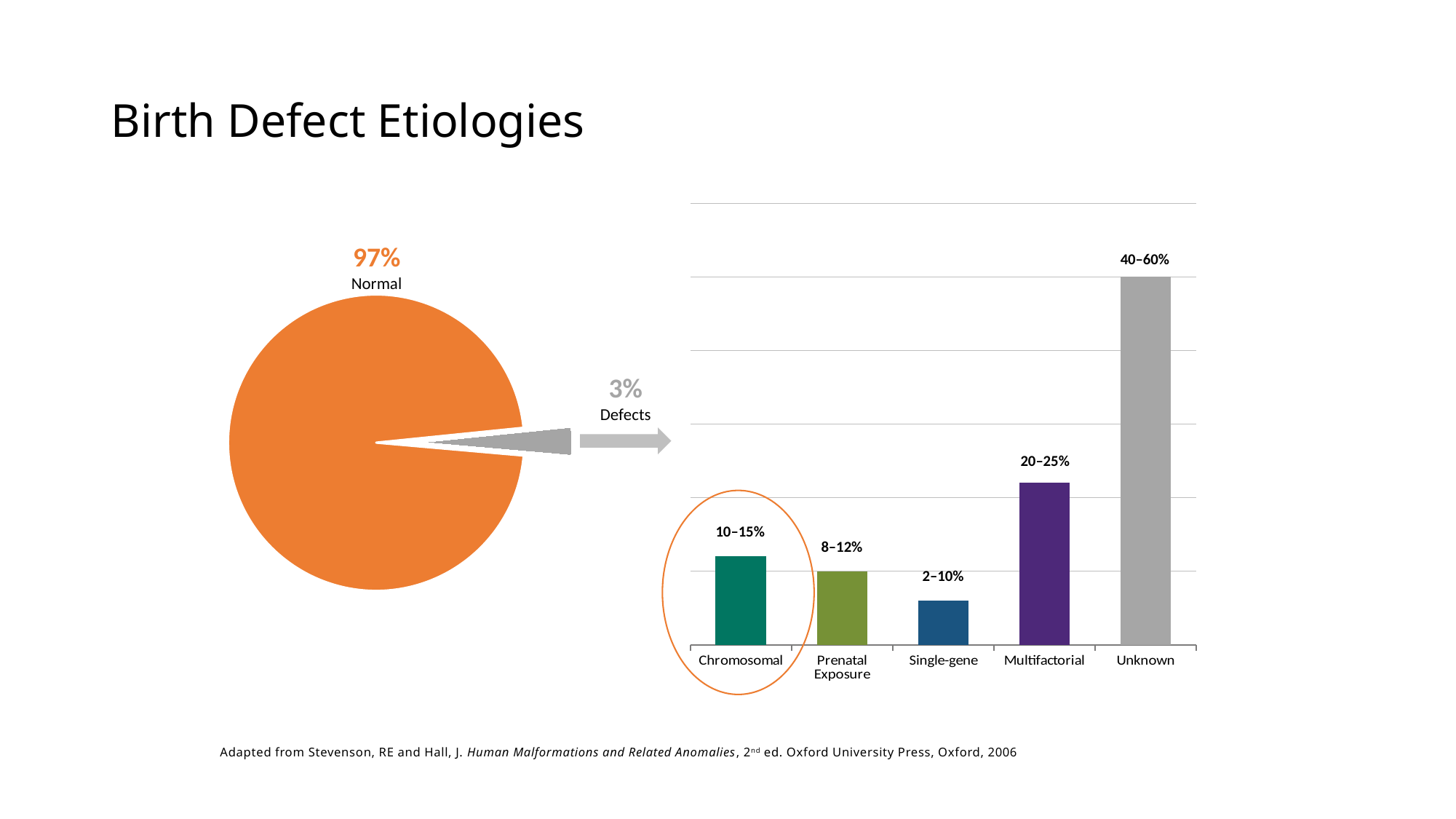
How many categories are shown in the bar chart on the right? 5 In the pie chart on the left, what share is labelled Normal? 97% In the bar chart on the right, which category has the shortest bar? Single-gene In the bar chart on the right, what is the value labelled for Chromosomal? 10–15% In the bar chart on the right, what is the value labelled for Multifactorial? 20–25% In the bar chart on the right, what is the value labelled for Prenatal Exposure? 8–12% In the bar chart on the right, which category has the tallest bar? Unknown In the bar chart on the right, what is the value labelled for Single-gene? 2–10% In the bar chart on the right, which bar is taller, Multifactorial or Chromosomal? Multifactorial In the bar chart on the right, what is the value labelled for Unknown? 40–60% In the pie chart on the left, what share is labelled Defects? 3% How many slices does the pie chart on the left have? 2